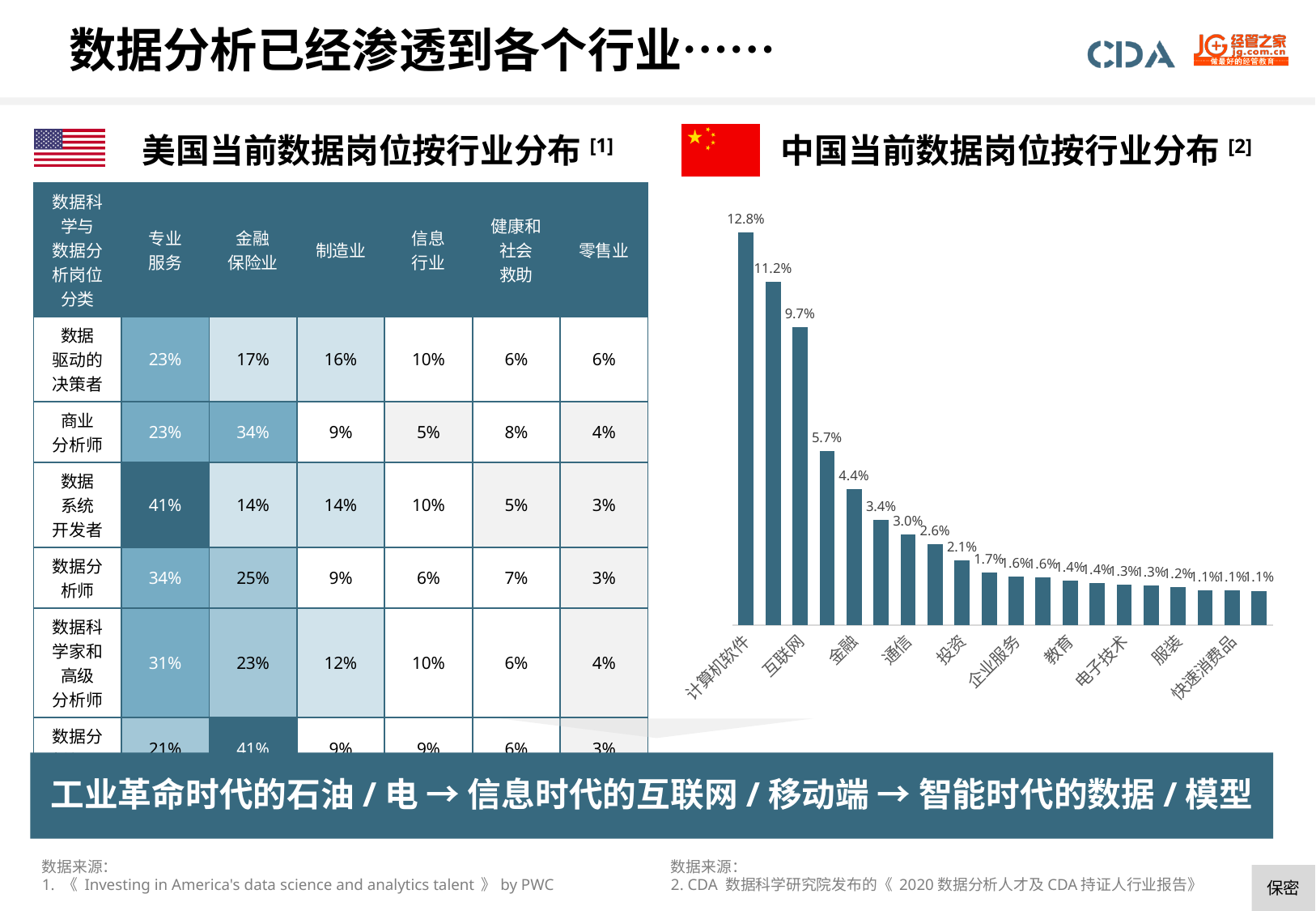
In the chart 中国当前数据岗位按行业分布, what is the difference between the highest bar (12.8%) and the lowest bar (1.1%)? 11.7% In the chart 中国当前数据岗位按行业分布, how many bars are plotted? 20 In the chart 中国当前数据岗位按行业分布, what is the lowest value shown on any bar? 1.1% In the chart 中国当前数据岗位按行业分布, do the values rise or fall from left to right? fall In the chart 中国当前数据岗位按行业分布, which is larger, the value for 计算机软件 or the value for 快速消费品? 计算机软件 What is the title of the bar chart on the right side of the slide? 中国当前数据岗位按行业分布 In the chart 中国当前数据岗位按行业分布, what is the value for 计算机软件? 12.8% In the chart 中国当前数据岗位按行业分布, what is the value of the second bar from the left? 11.2% In the chart 中国当前数据岗位按行业分布, what is the value for 互联网? 9.7% In the chart 中国当前数据岗位按行业分布, which industry has the highest value? 计算机软件 In the chart 中国当前数据岗位按行业分布, what is the highest value shown? 12.8% What kind of chart is shown on the right side of the slide under the title 中国当前数据岗位按行业分布? bar chart